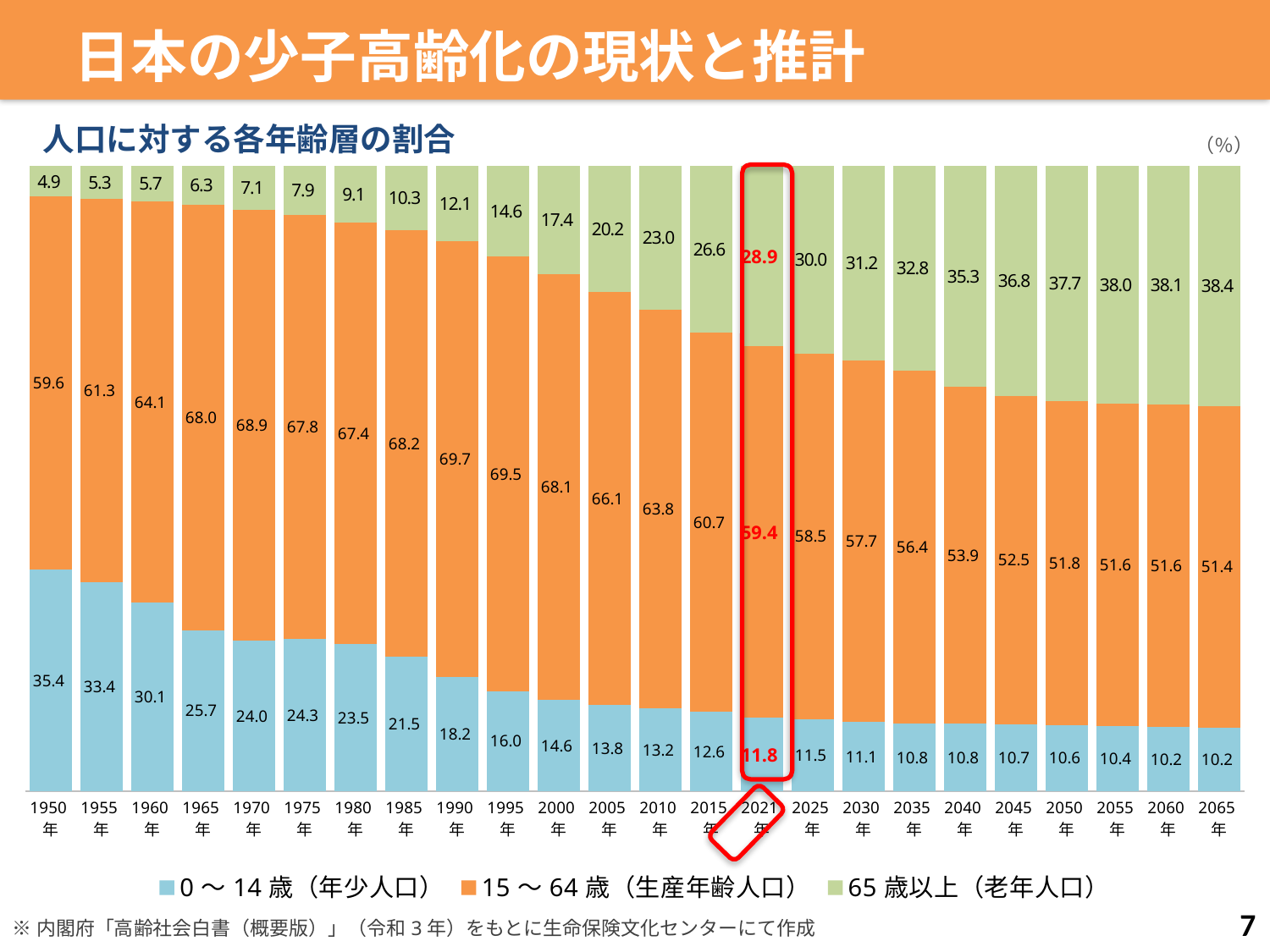
How many years (bars) are plotted on the x axis? 24 Does the share of the 0～14歳 group rise or fall from 1950 to 2065? Fall How many series does the legend list? 3 What is the share of the 0～14歳 (年少人口) group in 1950? 35.4 What kind of chart is shown on the slide? Stacked bar chart In which year is the share of the 15～64歳 group highest? 1990年 Which is larger, the 15～64歳 share in 2000 or in 2040? 2000 What is the title of the chart? 人口に対する各年齢層の割合 What is the difference between the 65歳以上 share in 2065 and in 1950? 33.5 What is the share of the 15～64歳 (生産年齢人口) group in 2065? 51.4 What is the share of the 65歳以上 (老年人口) group in 2021? 28.9 In which year is the share of the 65歳以上 group highest? 2065年